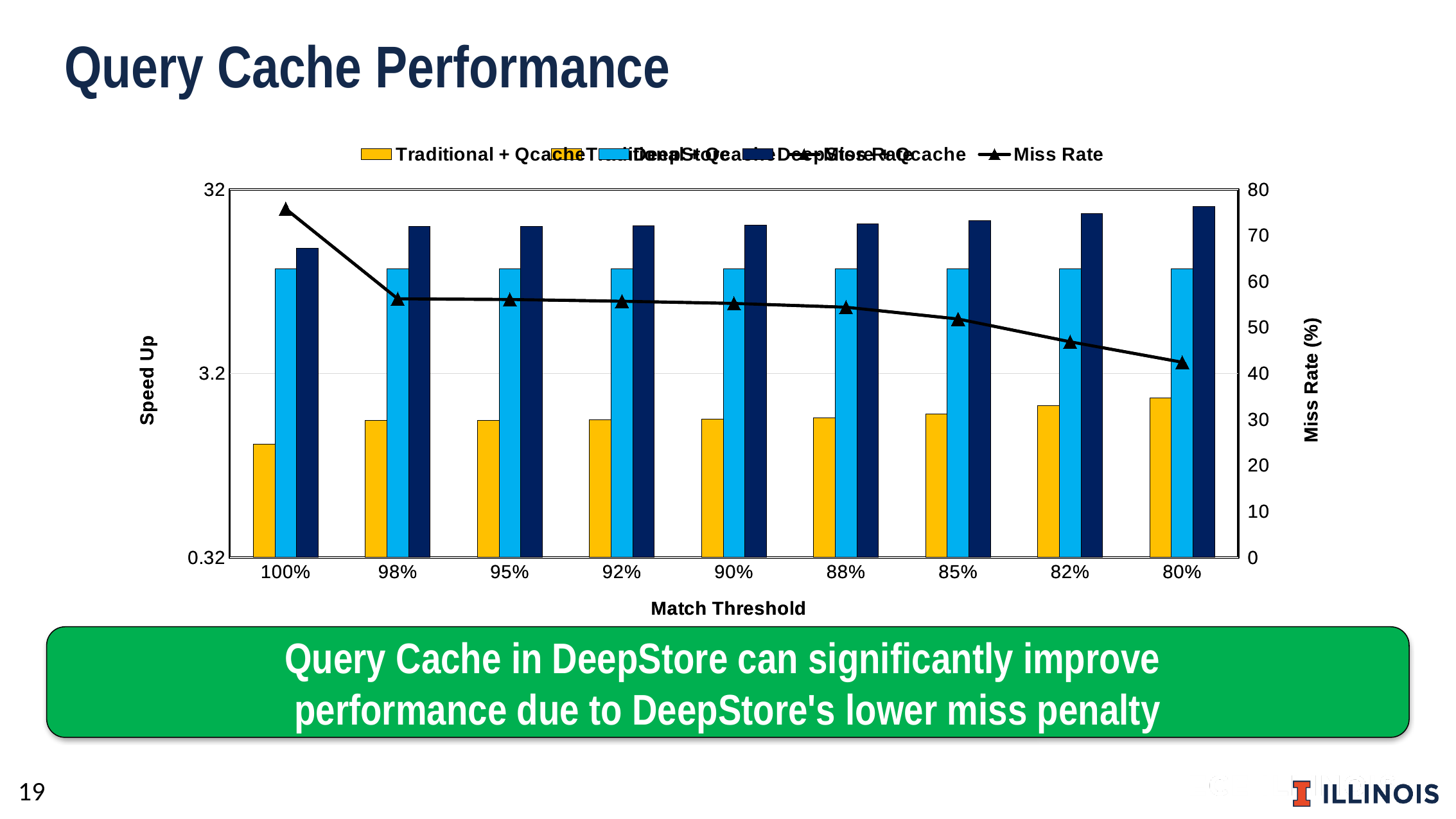
Is the Speed Up for Traditional + Qcache at the 100% match threshold greater or less than 3.2? less Which match threshold has the highest Miss Rate? 100% How many match threshold categories are shown on the x axis? 9 Is the Miss Rate at the 82% match threshold greater or less than 50? less Which match threshold has the lowest Miss Rate? 80% Does the Miss Rate rise or fall as the match threshold goes from 100% to 80% along the x axis? Fall What kind of chart is shown on the slide? Bar chart with a line What is the title of the right-hand y axis? Miss Rate (%) Do the Traditional + Qcache (yellow) bars rise or fall as the match threshold goes from 100% to 80%? Rise Is the Miss Rate at the 100% match threshold greater or less than 70? greater At the 100% match threshold, which is larger: the Speed Up of the dark blue bar or the Traditional + Qcache (yellow) bar? Dark blue bar